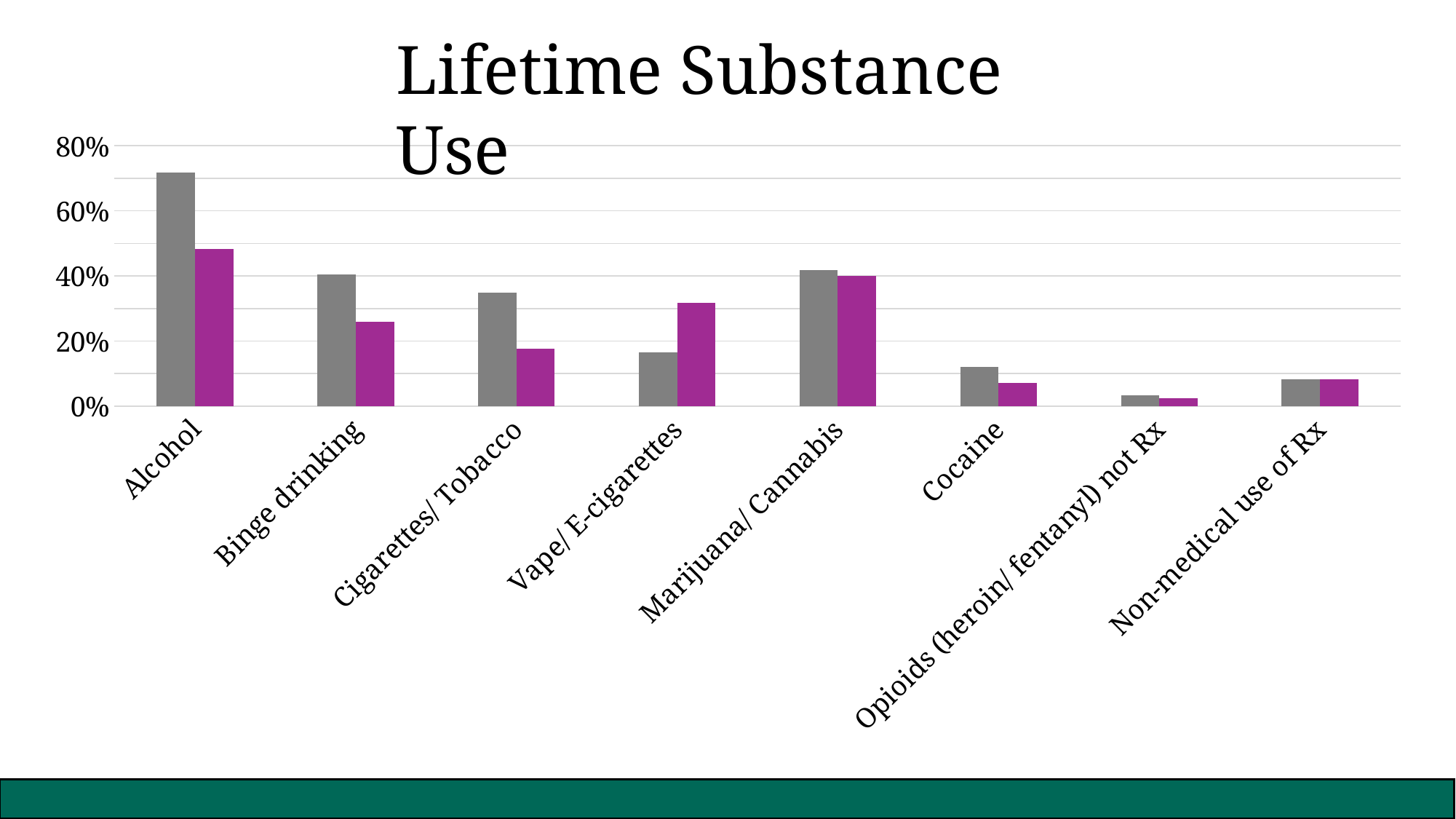
For Vape/ E-cigarettes, which bar is taller, the grey bar or the purple bar? purple How many substance categories are shown on the x axis? 8 Is the grey bar for Alcohol greater or less than 60%? greater What is the title of the chart? Lifetime Substance Use Is the grey bar for Marijuana/ Cannabis greater or less than 20%? greater Which category has the highest grey bar? Alcohol What kind of chart is shown on the slide? bar chart For Cigarettes/ Tobacco, which bar is taller, the grey bar or the purple bar? grey Is the grey bar for Binge drinking greater or less than 20%? greater Which category has the lowest purple bar? Opioids (heroin/ fentanyl) not Rx